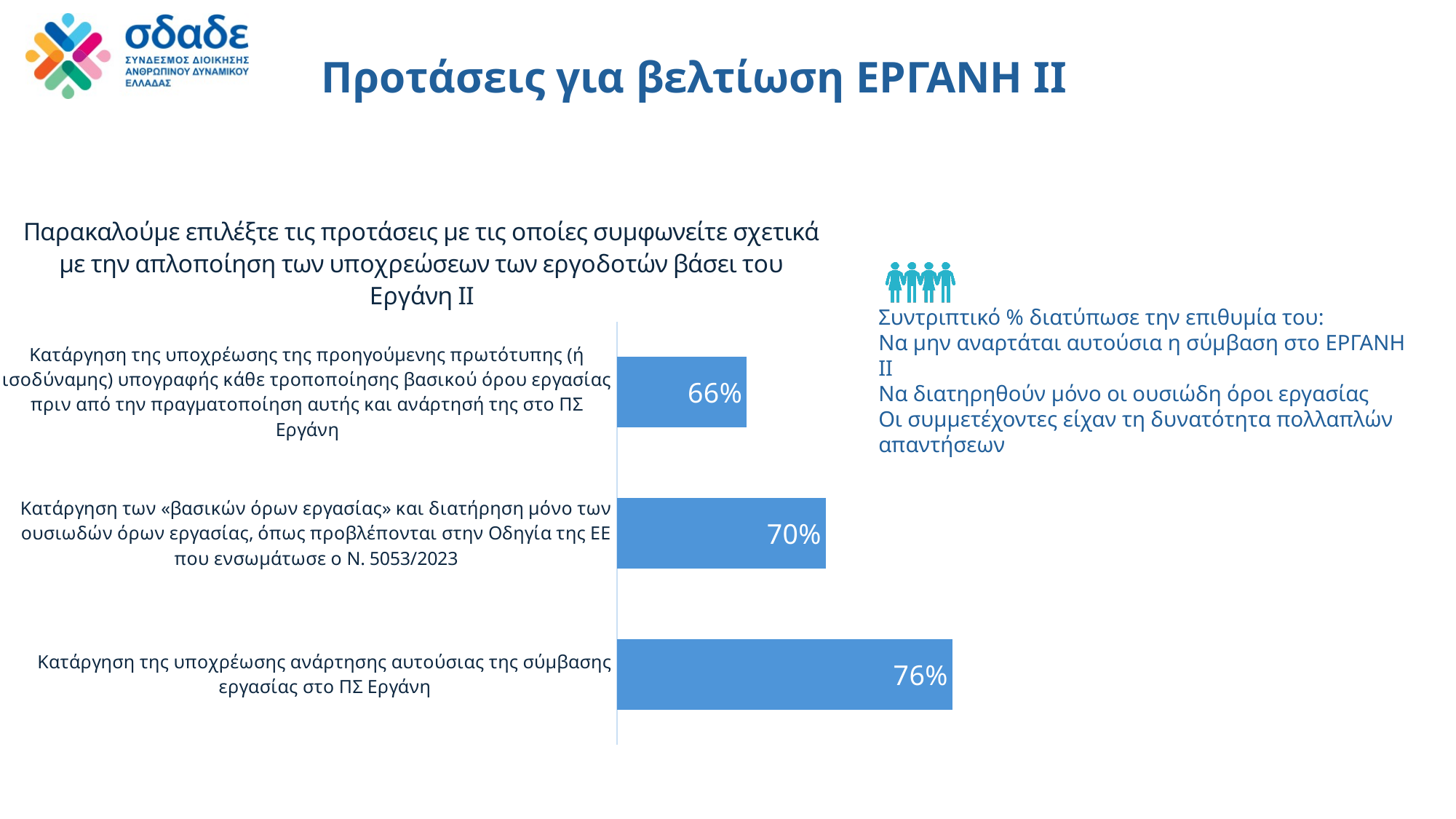
What is the difference between the highest value (76%) and the lowest value (66%)? 10% What is the value for 'Κατάργηση της υποχρέωσης της προηγούμενης πρωτότυπης (ή ισοδύναμης) υπογραφής κάθε τροποποίησης βασικού όρου εργασίας πριν από την πραγματοποίηση αυτής και ανάρτησή της στο ΠΣ Εργάνη'? 66% What colour are the bars in the chart? Blue What is the value for 'Κατάργηση των «βασικών όρων εργασίας» και διατήρηση μόνο των ουσιωδών όρων εργασίας, όπως προβλέπονται στην Οδηγία της ΕΕ που ενσωμάτωσε ο Ν. 5053/2023'? 70% How many categories are shown in the chart? 3 What is the value for 'Κατάργηση της υποχρέωσης ανάρτησης αυτούσιας της σύμβασης εργασίας στο ΠΣ Εργάνη'? 76% Which is larger: the value for 'Κατάργηση της υποχρέωσης ανάρτησης αυτούσιας της σύμβασης εργασίας στο ΠΣ Εργάνη' or the value for 'Κατάργηση των «βασικών όρων εργασίας»...'? Κατάργηση της υποχρέωσης ανάρτησης αυτούσιας της σύμβασης εργασίας στο ΠΣ Εργάνη What is the title of the chart? Παρακαλούμε επιλέξτε τις προτάσεις με τις οποίες συμφωνείτε σχετικά με την απλοποίηση των υποχρεώσεων των εργοδοτών βάσει του Εργάνη ΙΙ Which category has the highest value? Κατάργηση της υποχρέωσης ανάρτησης αυτούσιας της σύμβασης εργασίας στο ΠΣ Εργάνη What is the difference between the value for 'Κατάργηση των «βασικών όρων εργασίας»...' (70%) and 'Κατάργηση της υποχρέωσης της προηγούμενης πρωτότυπης...' (66%)? 4% What kind of chart is shown on the slide? Bar chart Which category has the lowest value? Κατάργηση της υποχρέωσης της προηγούμενης πρωτότυπης (ή ισοδύναμης) υπογραφής κάθε τροποποίησης βασικού όρου εργασίας πριν από την πραγματοποίηση αυτής και ανάρτησή της στο ΠΣ Εργάνη